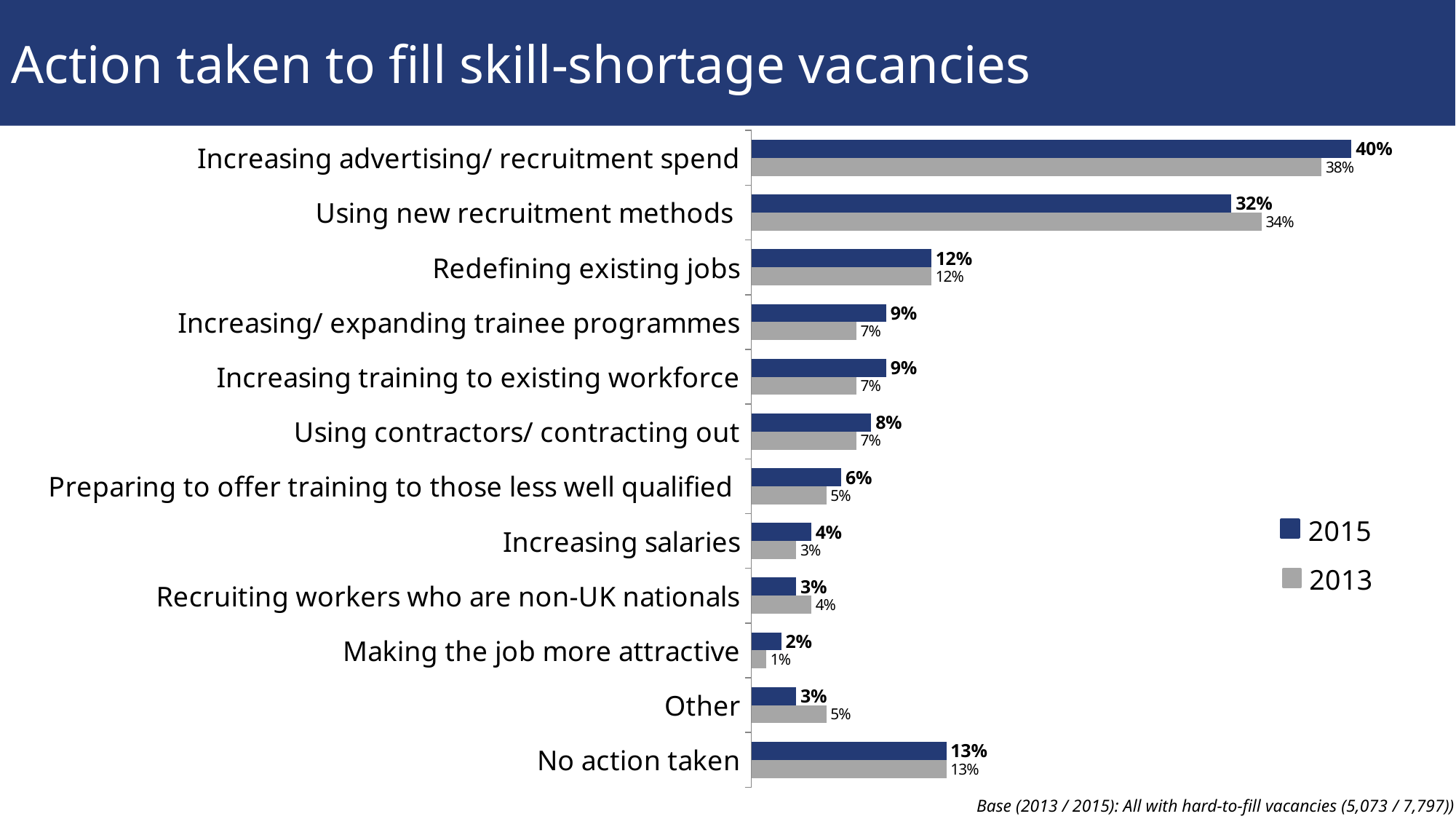
What is the difference between the 2015 and 2013 values for Using new recruitment methods? 2% What kind of chart is shown on the slide? Bar chart What is the title of the slide? Action taken to fill skill-shortage vacancies How many categories are shown on the chart? 12 What is the 2015 value for Increasing advertising/ recruitment spend? 40% What is the 2015 value for No action taken? 13% Which is larger for Recruiting workers who are non-UK nationals: the 2015 value or the 2013 value? 2013 Which category has the lowest 2013 value? Making the job more attractive Which category has the highest 2015 value? Increasing advertising/ recruitment spend What is the 2013 value for Using new recruitment methods? 34% How many series does the legend list? 2 What is the difference between the 2015 values for Increasing advertising/ recruitment spend and Using new recruitment methods? 8%